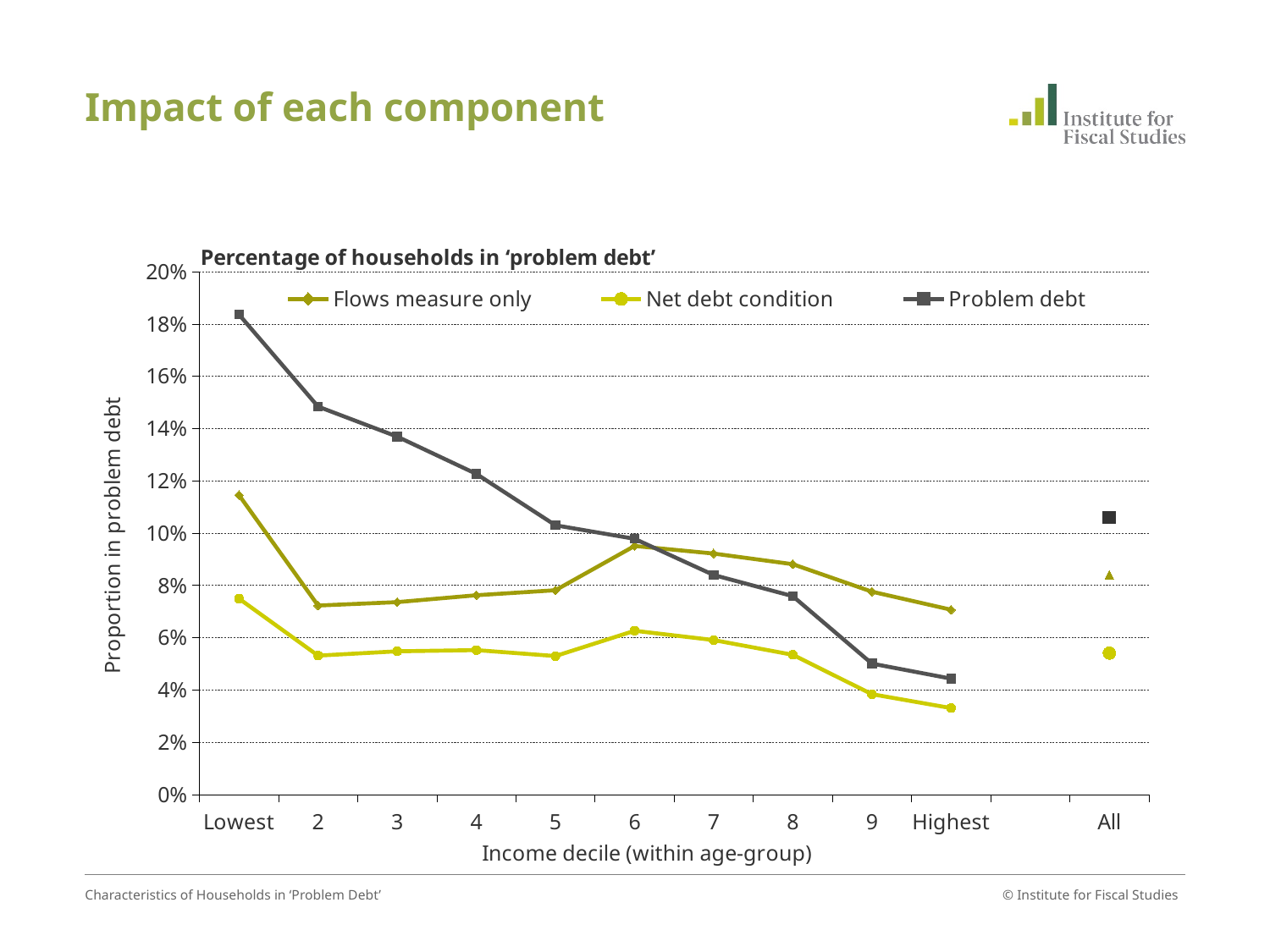
Is the value for Problem debt for 'All' greater or less than 10%? greater How many series does the legend list? 3 Is the value for Net debt condition at the Highest income decile greater or less than 4%? less How many categories are shown on the x axis, including 'All'? 11 What kind of chart is shown on the slide? line chart Is the value for Flows measure only at decile 6 greater or less than 8%? greater At decile 2, which is larger: Problem debt or Flows measure only? Problem debt Which income decile has the lowest value for Net debt condition? Highest Which income decile has the highest value for Problem debt? Lowest Does the Problem debt series generally rise or fall from the Lowest to the Highest income decile? fall What is the title of the chart? Percentage of households in 'problem debt'